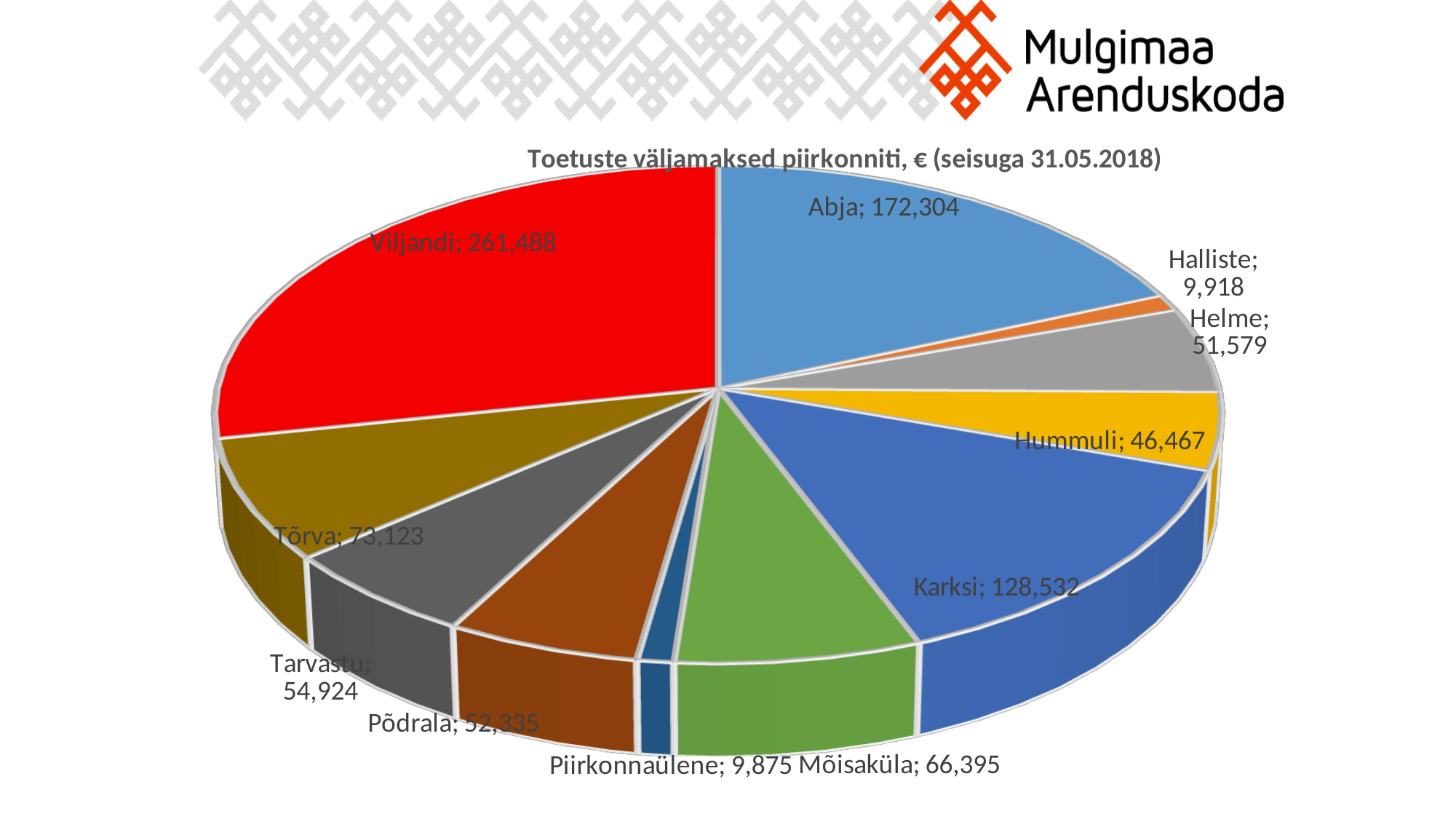
What is the difference between the values for Viljandi and Abja? 89,184 What is the value for Karksi? 128,532 How many regions (slices) are shown in the pie chart? 11 What is the value for Viljandi? 261,488 What is the value for Hummuli? 46,467 Which region has the highest value? Viljandi What is the value for Piirkonnaülene? 9,875 What type of chart is shown on the slide? Pie chart What is the difference between the values for Karksi and Mõisaküla? 62,137 What is the title of the chart? Toetuste väljamaksed piirkonniti, € (seisuga 31.05.2018) Which is larger, the value for Tõrva or the value for Tarvastu? Tõrva Which region has the lowest value? Piirkonnaülene